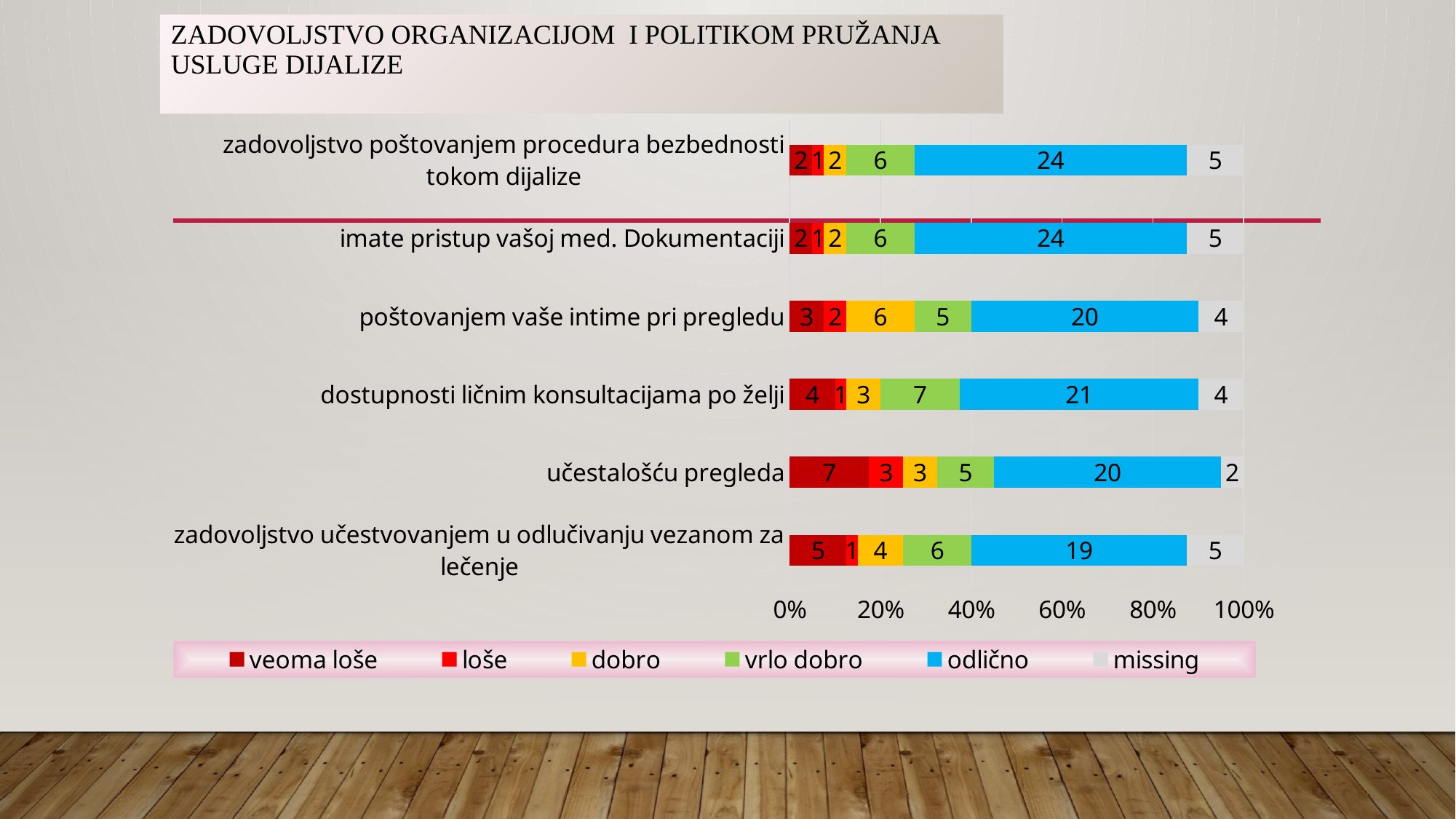
Which is larger: the 'dobro' value for 'poštovanjem vaše intime pri pregledu' or for 'učestalošću pregleda'? poštovanjem vaše intime pri pregledu Which category has the lowest 'odlično' value? zadovoljstvo učestvovanjem u odlučivanju vezanom za lečenje What kind of chart is shown on the slide? stacked bar chart Which category has the highest 'veoma loše' value? učestalošću pregleda How many categories (questions) are plotted on the chart? 6 What is the total of all segments in the bar for 'učestalošću pregleda'? 40 What is the 'vrlo dobro' value for 'dostupnosti ličnim konsultacijama po želji'? 7 What is the difference between the 'odlično' value for 'imate pristup vašoj med. Dokumentaciji' and for 'poštovanjem vaše intime pri pregledu'? 4 How many series does the legend list? 6 What is the 'odlično' value for 'učestalošću pregleda'? 20 Which legend entry is shown in blue? odlično What is the 'veoma loše' value for 'zadovoljstvo učestvovanjem u odlučivanju vezanom za lečenje'? 5